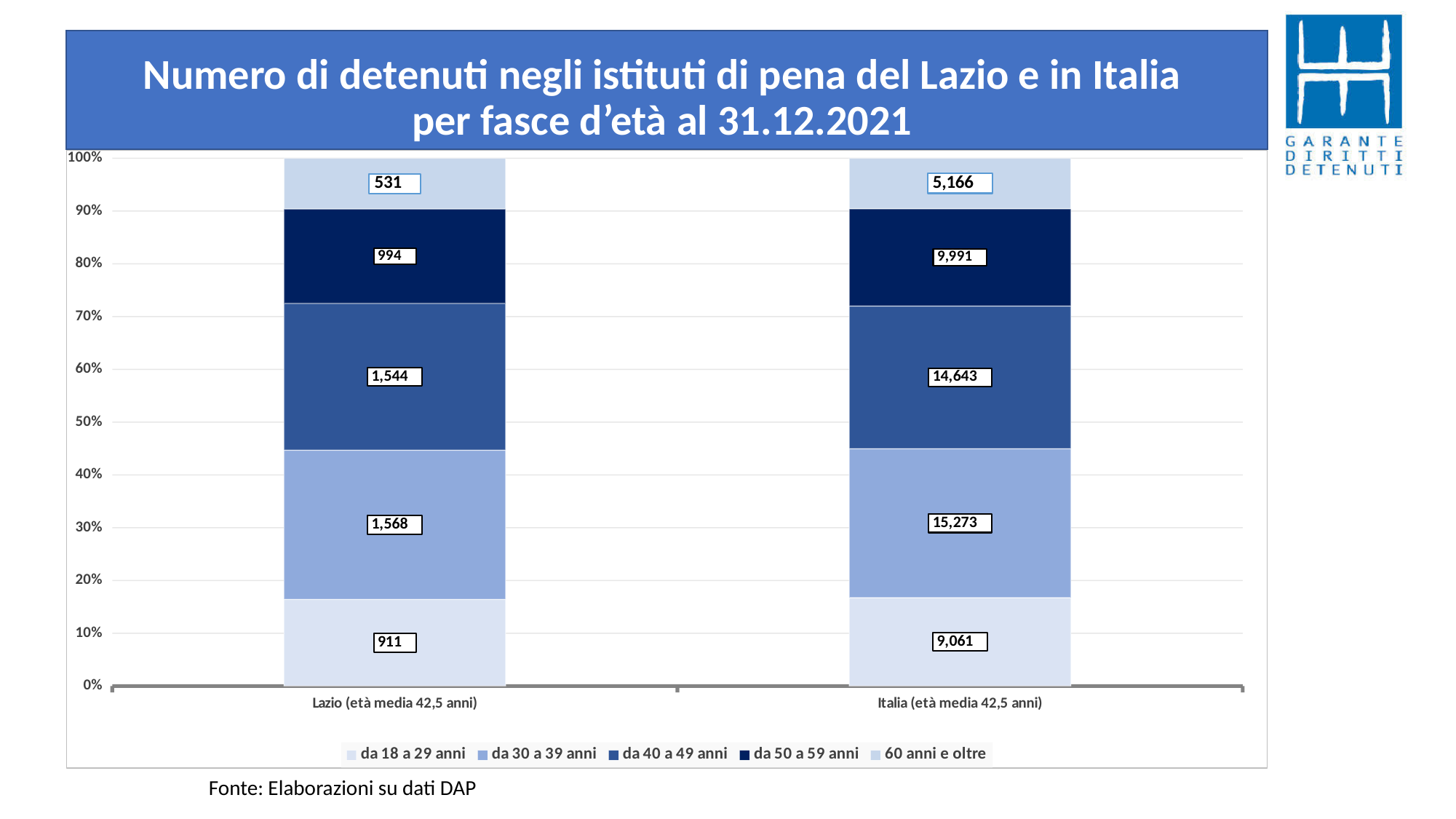
How many series does the legend list? 5 How many bars (categories) are plotted on the x axis? 2 What is the total number of detainees in the Lazio bar, summing all five age groups? 5,548 What is the difference between the 'da 50 a 59 anni' value for Italia and the 'da 50 a 59 anni' value for Lazio? 8,997 What is the value for the 'da 40 a 49 anni' segment in the Italia bar? 14,643 In Lazio, which is larger: the 'da 30 a 39 anni' segment or the 'da 40 a 49 anni' segment? da 30 a 39 anni What is the source cited below the chart? Elaborazioni su dati DAP Which age group has the largest number of detainees in Lazio? da 30 a 39 anni How many detainees aged 18 to 29 (da 18 a 29 anni) are shown for Lazio? 911 What kind of chart is shown on the slide? Stacked bar chart What is the value for the '60 anni e oltre' segment in the Italia bar? 5,166 Which age group has the smallest number of detainees in Italia? 60 anni e oltre